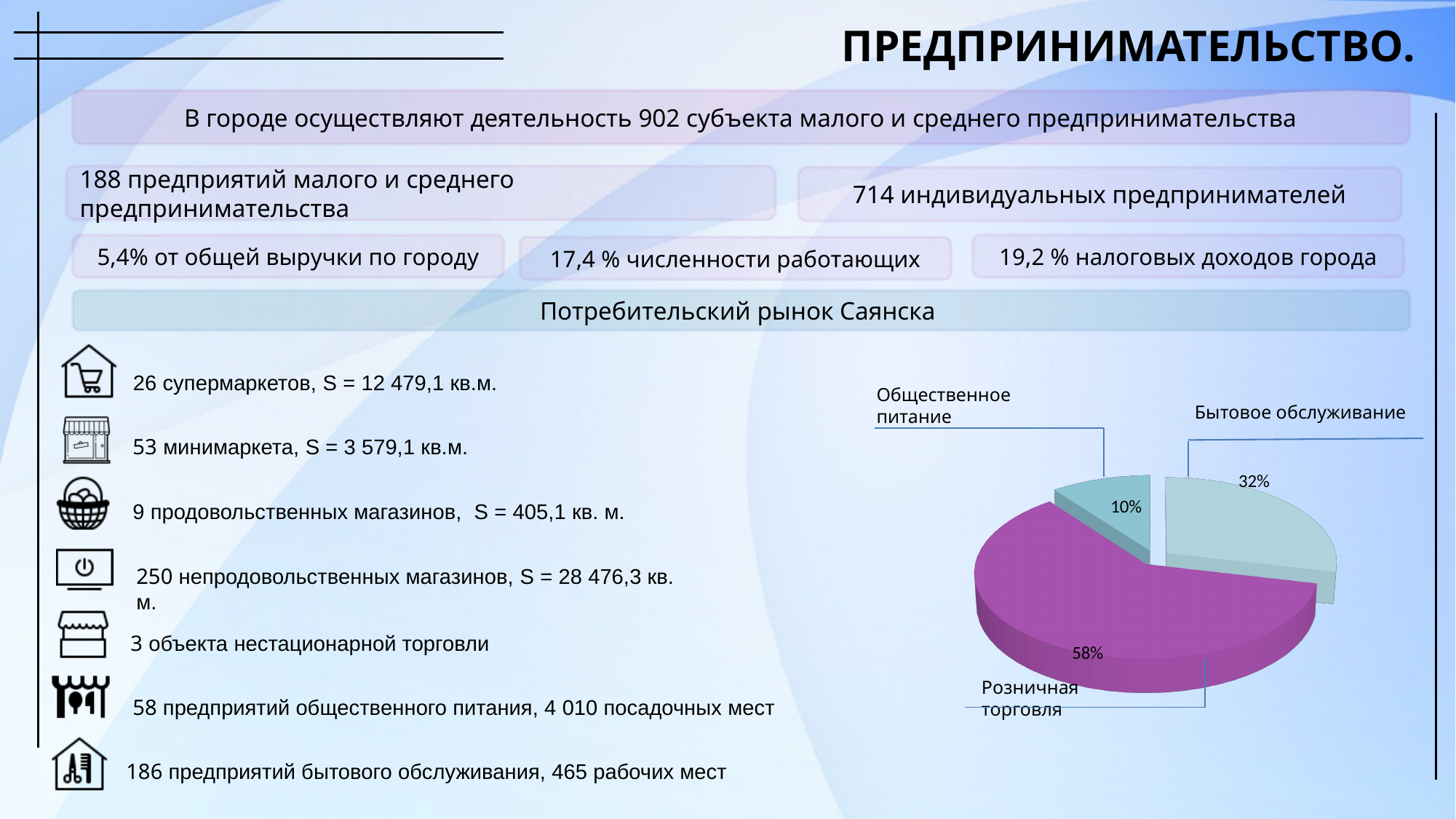
How many slices does the pie chart have? 3 What colour is the Розничная торговля slice in the pie chart? Purple (magenta) What is the difference in percentage points between the Розничная торговля slice and the Бытовое обслуживание slice? 26 What share of the pie chart is labelled Общественное питание? 10% What is the difference in percentage points between the Бытовое обслуживание slice and the Общественное питание slice? 22 Which category has the largest slice in the pie chart? Розничная торговля Which category has the smallest slice in the pie chart? Общественное питание What type of chart is shown on the slide? Pie chart Is the pie chart drawn in 3D? Yes What share of the pie chart is labelled Розничная торговля? 58% What share of the pie chart is labelled Бытовое обслуживание? 32% Which slice is larger in the pie chart: Бытовое обслуживание or Общественное питание? Бытовое обслуживание